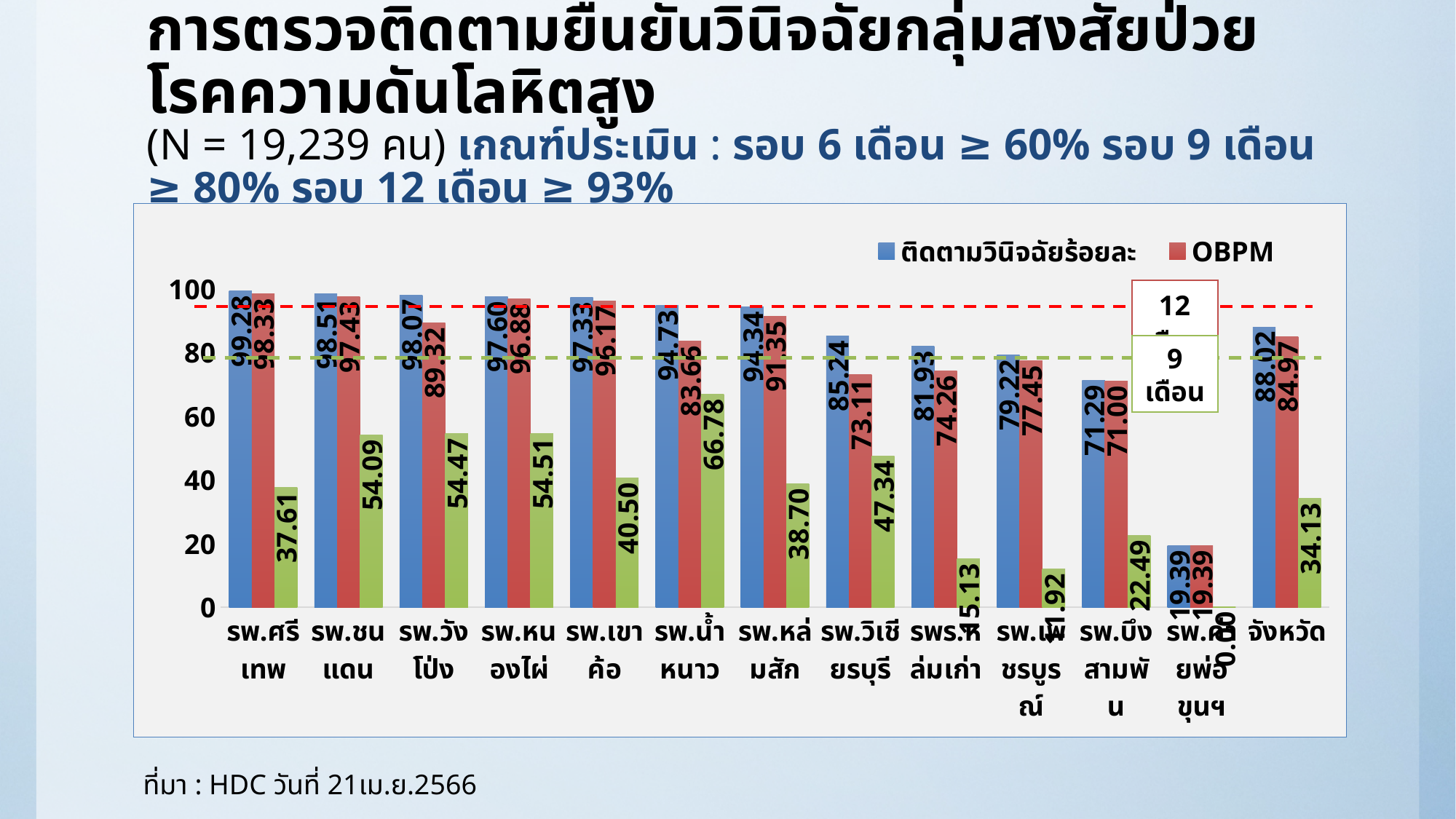
How many categories are shown on the x axis of the chart? 13 What is the OBPM value for รพ.วังโป่ง? 89.32 What is the difference between the ติดตามวินิจฉัยร้อยละ and OBPM values for รพ.น้ำหนาว? 11.07 What is the ติดตามวินิจฉัยร้อยละ value for รพ.ศรีเทพ? 99.28 What is the ติดตามวินิจฉัยร้อยละ value for รพ.ค่ายพ่อขุนฯ? 19.39 How many series does the legend list? 2 Which has a higher ติดตามวินิจฉัยร้อยละ value, รพ.วิเชียรบุรี or รพร.หล่มเก่า? รพ.วิเชียรบุรี Which category has the highest ติดตามวินิจฉัยร้อยละ value? รพ.ศรีเทพ What is the difference between the ติดตามวินิจฉัยร้อยละ and OBPM values for รพ.บึงสามพัน? 0.29 What kind of chart is shown on the slide? Bar chart What is the OBPM value for จังหวัด? 84.97 Which category has the lowest OBPM value? รพ.ค่ายพ่อขุนฯ